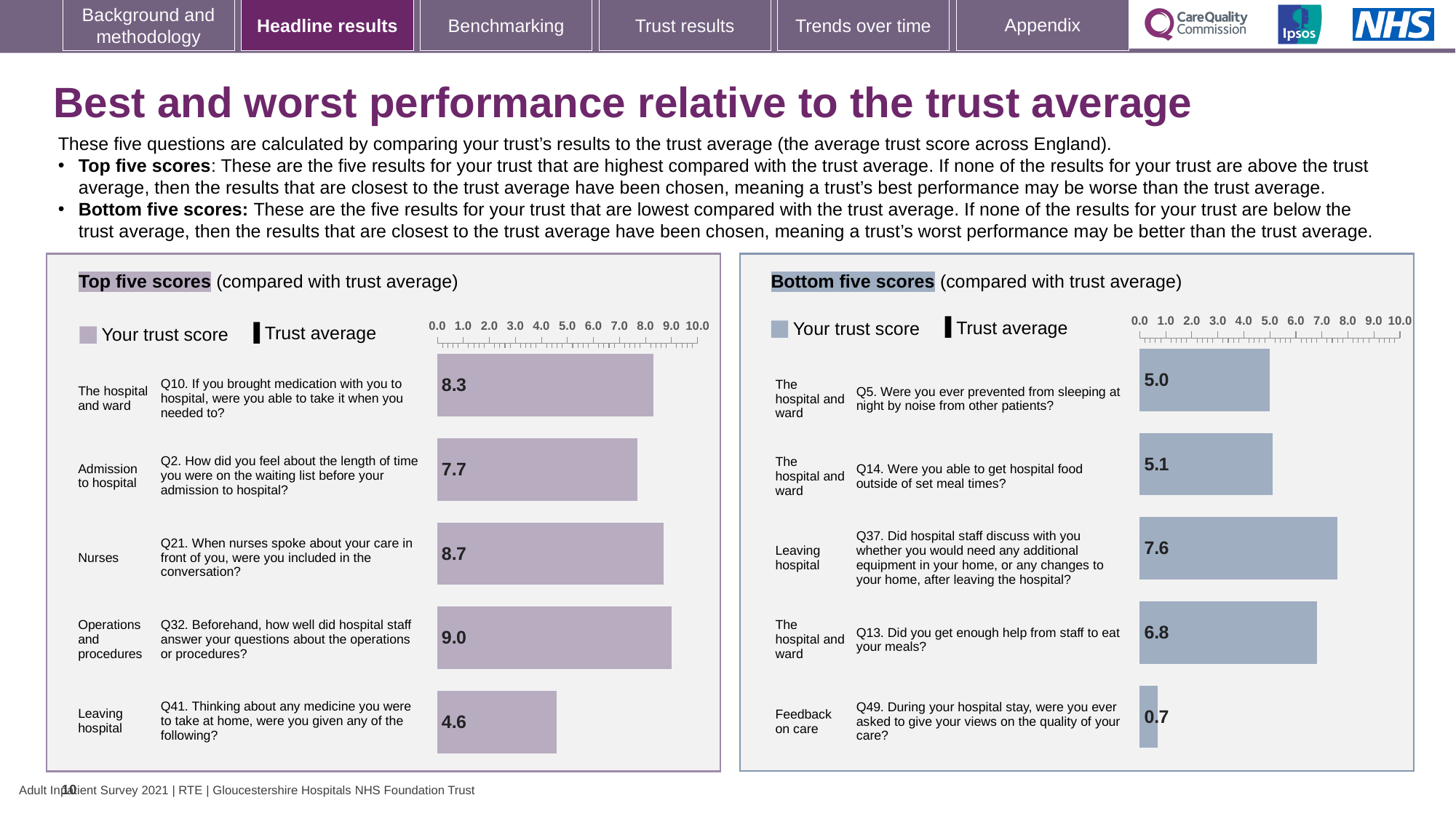
In the Top five scores chart, which question has the lowest trust score? Q41 (4.6) In the Bottom five scores chart, which has the larger score, Q5 or Q37? Q37 In the Top five scores chart, what is the difference between the scores for Q32 and Q41? 4.4 In the Top five scores chart, which question has the highest trust score? Q32 (9.0) How many questions are shown in the Bottom five scores chart? 5 In the Top five scores chart, what is the trust score for Q10 (taking medication brought to hospital)? 8.3 In the Bottom five scores chart, what is the trust score for Q13 (enough help from staff to eat meals)? 6.8 What kind of chart is the Top five scores chart? Bar chart In the Bottom five scores chart, which question has the lowest trust score? Q49 (0.7) In the Bottom five scores chart, what is the trust score for Q49 (asked to give views on quality of care)? 0.7 In the Top five scores chart, what is the trust score for Q21 (nurses including you in the conversation)? 8.7 In the Bottom five scores chart, what is the difference between the scores for Q37 and Q49? 6.9